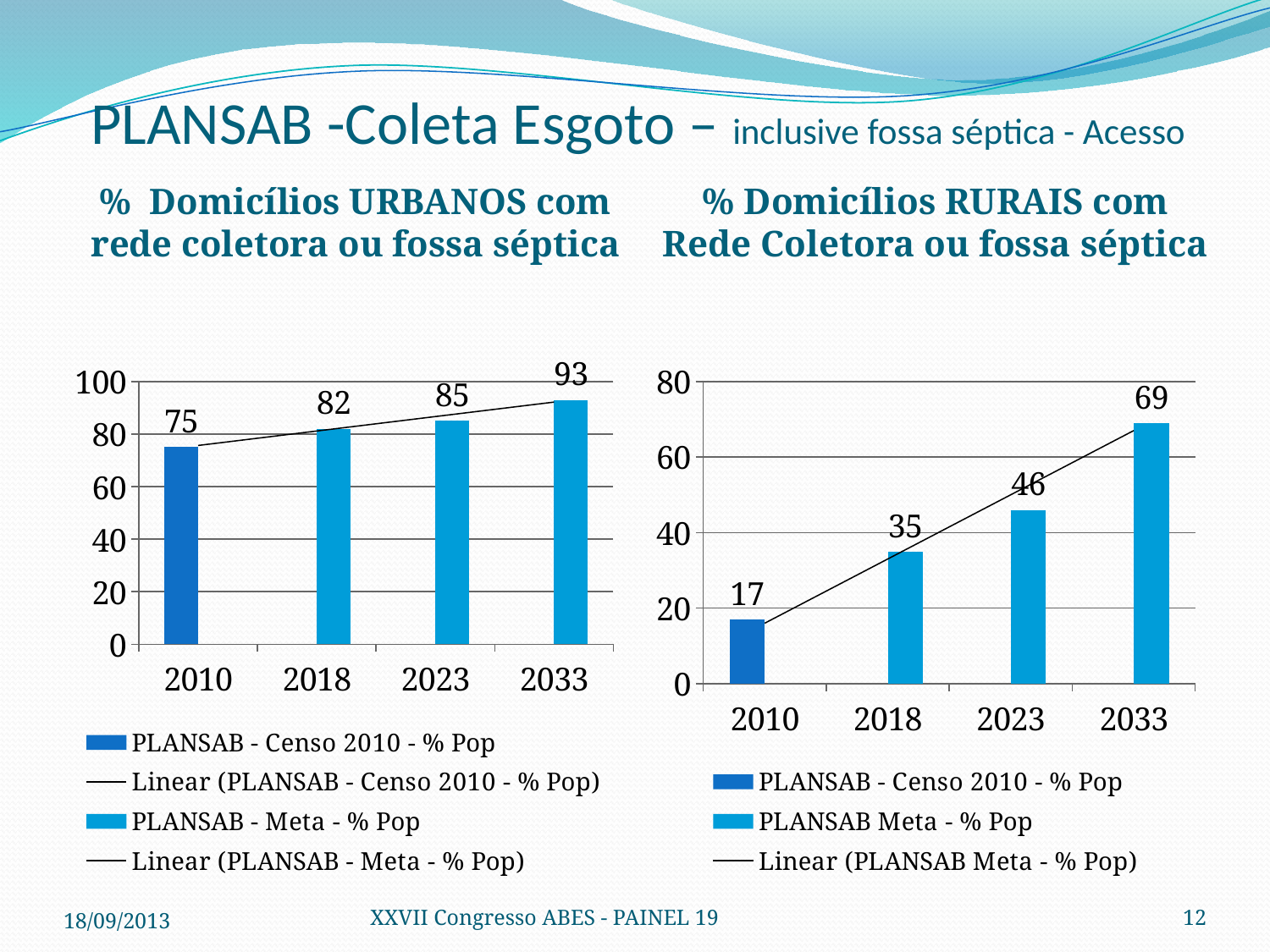
In the urban households chart (left), what is the difference between the values for 2018 and 2023? 3 In the rural households chart (right), what is the difference between the values for 2033 and 2010? 52 In the rural households chart (right), what is the value for 2018? 35 In the urban households chart (left), which year has the lowest value? 2010 In the rural households chart (right), which year has the highest value? 2033 In the urban households chart (left), what is the value for 2010? 75 Do the values in the rural households chart (right) rise or fall from 2010 to 2033? Rise In the urban households chart (left), what is the value for 2033? 93 Which is larger: the 2023 value in the urban chart (left) or the 2023 value in the rural chart (right)? Urban chart (85) What type of chart is the urban households chart (left)? Bar chart How many years are shown on the x axis of the rural households chart (right)? 4 In the rural households chart (right), what is the value for 2023? 46